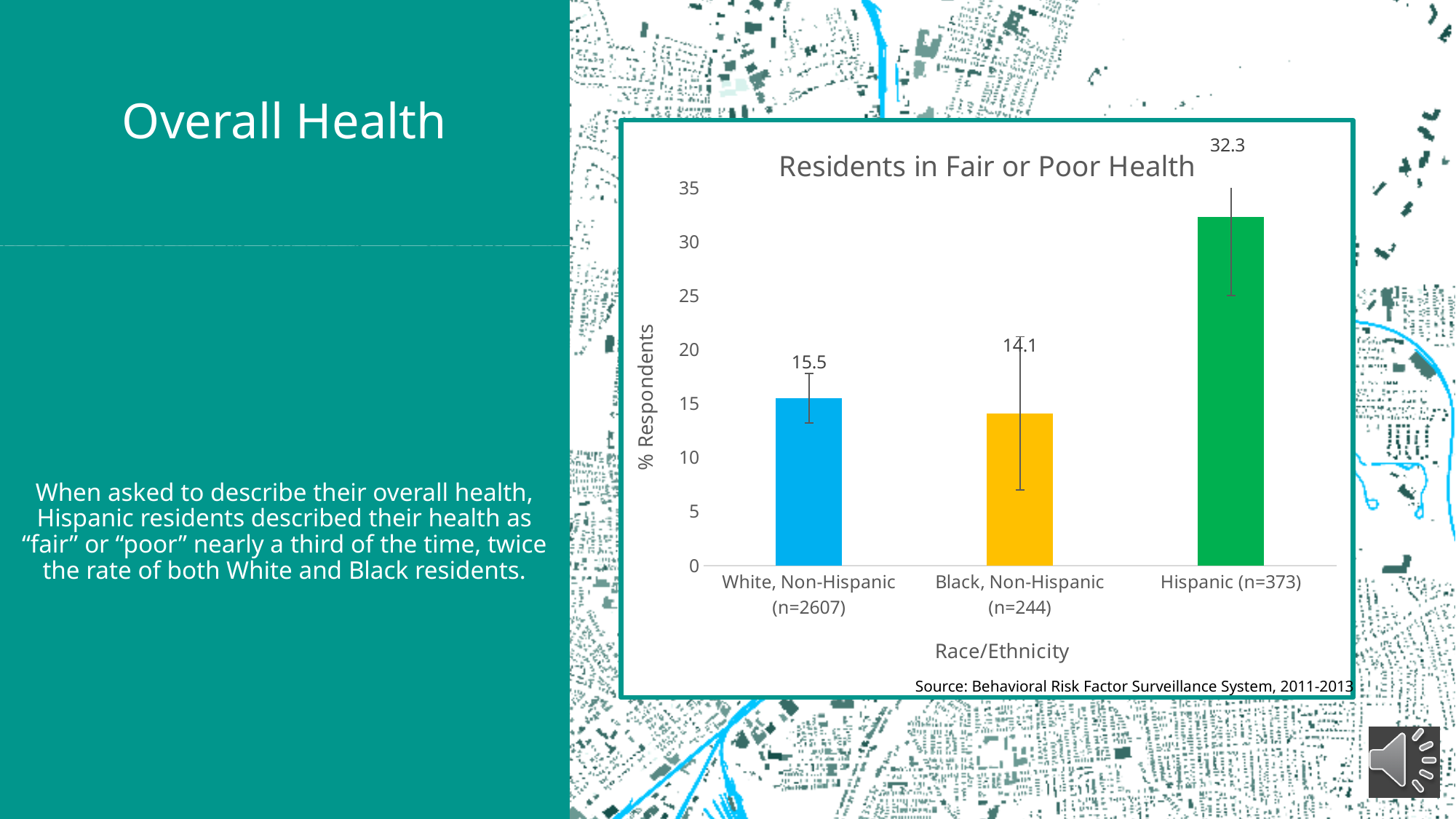
What kind of chart is shown on the slide? Bar chart What is the difference between the values for Hispanic (n=373) and White, Non-Hispanic (n=2607)? 16.8 What is the difference between the values for White, Non-Hispanic (n=2607) and Black, Non-Hispanic (n=244)? 1.4 Which race/ethnicity group has the lowest percentage of residents in fair or poor health? Black, Non-Hispanic (n=244) What is the value for Black, Non-Hispanic (n=244) in the Residents in Fair or Poor Health chart? 14.1 What is the value for Hispanic (n=373) in the Residents in Fair or Poor Health chart? 32.3 How many race/ethnicity categories are shown in the chart? 3 Which race/ethnicity group has the highest percentage of residents in fair or poor health? Hispanic (n=373) Which is larger, the value for Hispanic (n=373) or the value for Black, Non-Hispanic (n=244)? Hispanic (n=373) What is the value for White, Non-Hispanic (n=2607) in the Residents in Fair or Poor Health chart? 15.5 Is the value for Hispanic (n=373) greater or less than 30? greater What is the label of the y axis in the chart? % Respondents